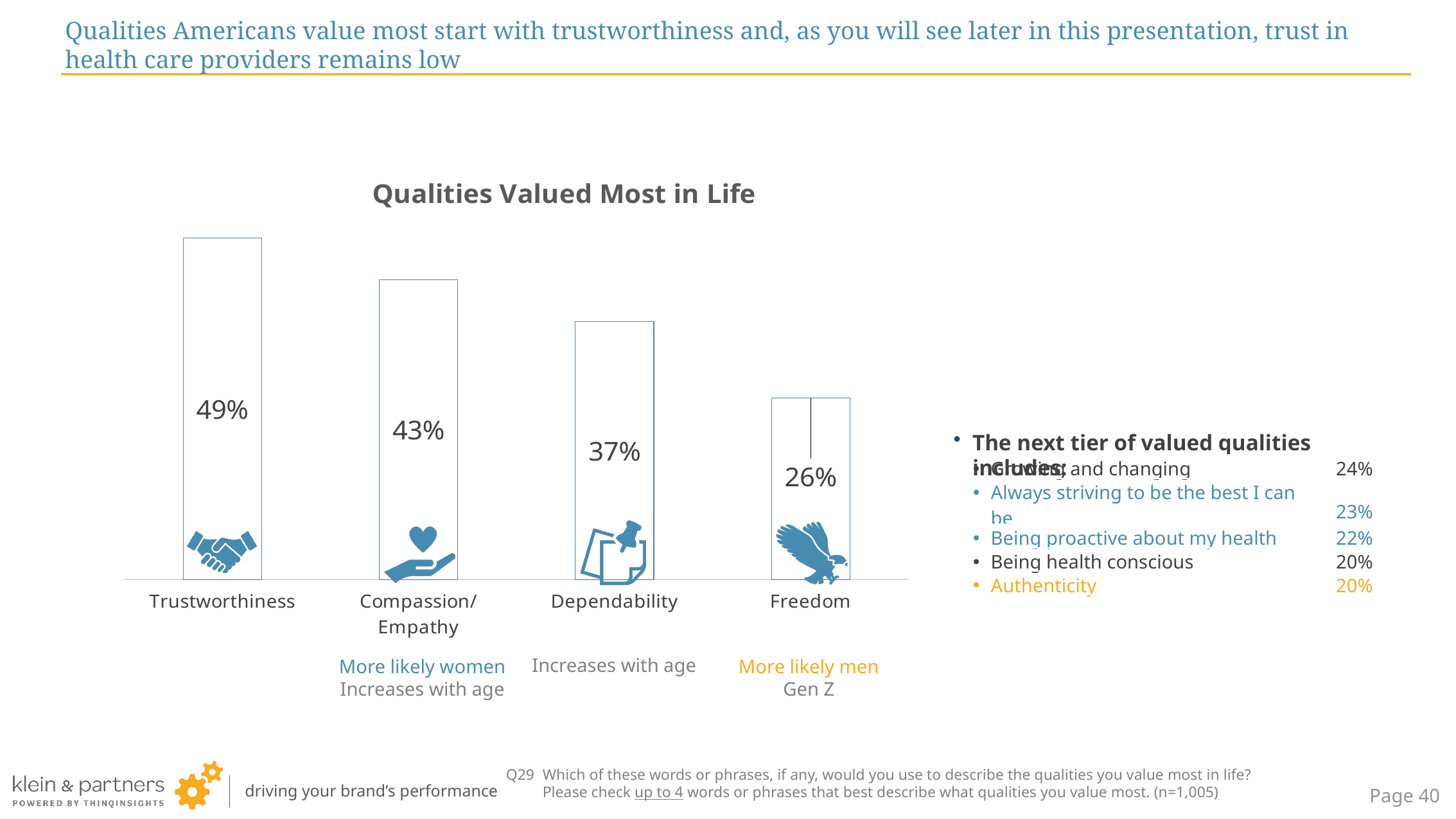
Which quality has the lowest value in the chart? Freedom What is the difference between the values for Compassion/Empathy and Dependability? 6% What is the value for Freedom? 26% What kind of chart is shown on the slide? Bar chart What is the value for Dependability? 37% What is the difference between the values for Trustworthiness and Freedom? 23% Which quality has the highest value in the chart? Trustworthiness What is the value for Trustworthiness in the Qualities Valued Most in Life chart? 49% How many qualities are plotted in the chart? 4 What is the title of the chart? Qualities Valued Most in Life What is the value for Compassion/Empathy? 43% Which is larger, the value for Dependability or the value for Freedom? Dependability